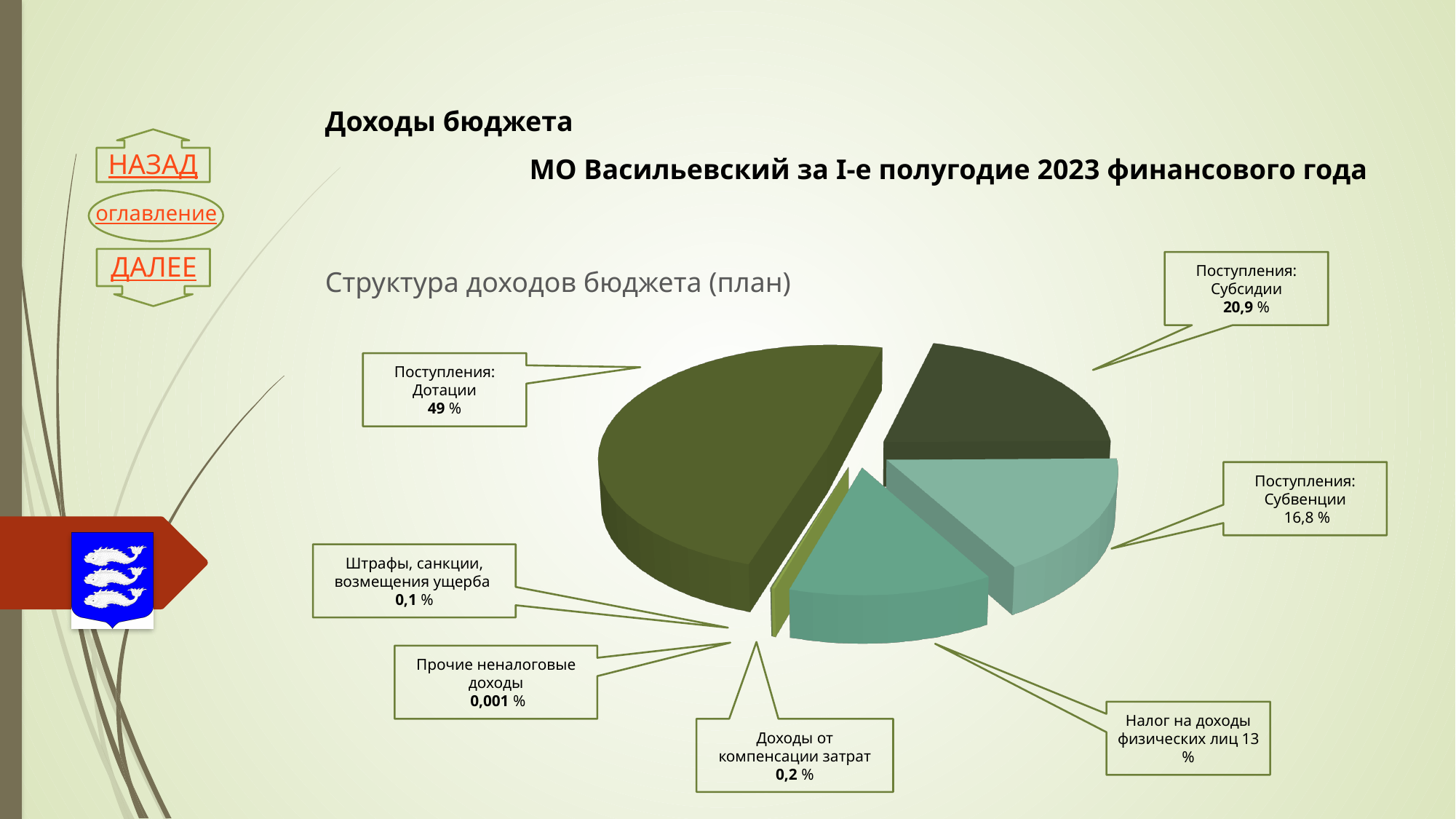
Which category has the largest share of the pie? Поступления: Дотации What value is shown for Поступления: Субсидии? 20,9 % What value is shown for Доходы от компенсации затрат? 0,2 % How many categories are labelled on the pie chart? 7 What value is shown for Налог на доходы физических лиц? 13 % What share of the pie is labelled for Поступления: Дотации? 49 % What is the title of the chart? Структура доходов бюджета (план) Which is larger: Поступления: Субсидии or Поступления: Субвенции? Поступления: Субсидии What value is shown for Поступления: Субвенции? 16,8 % What kind of chart is shown on the slide? pie chart What value is shown for Прочие неналоговые доходы? 0,001 % Which category has the smallest share of the pie? Прочие неналоговые доходы